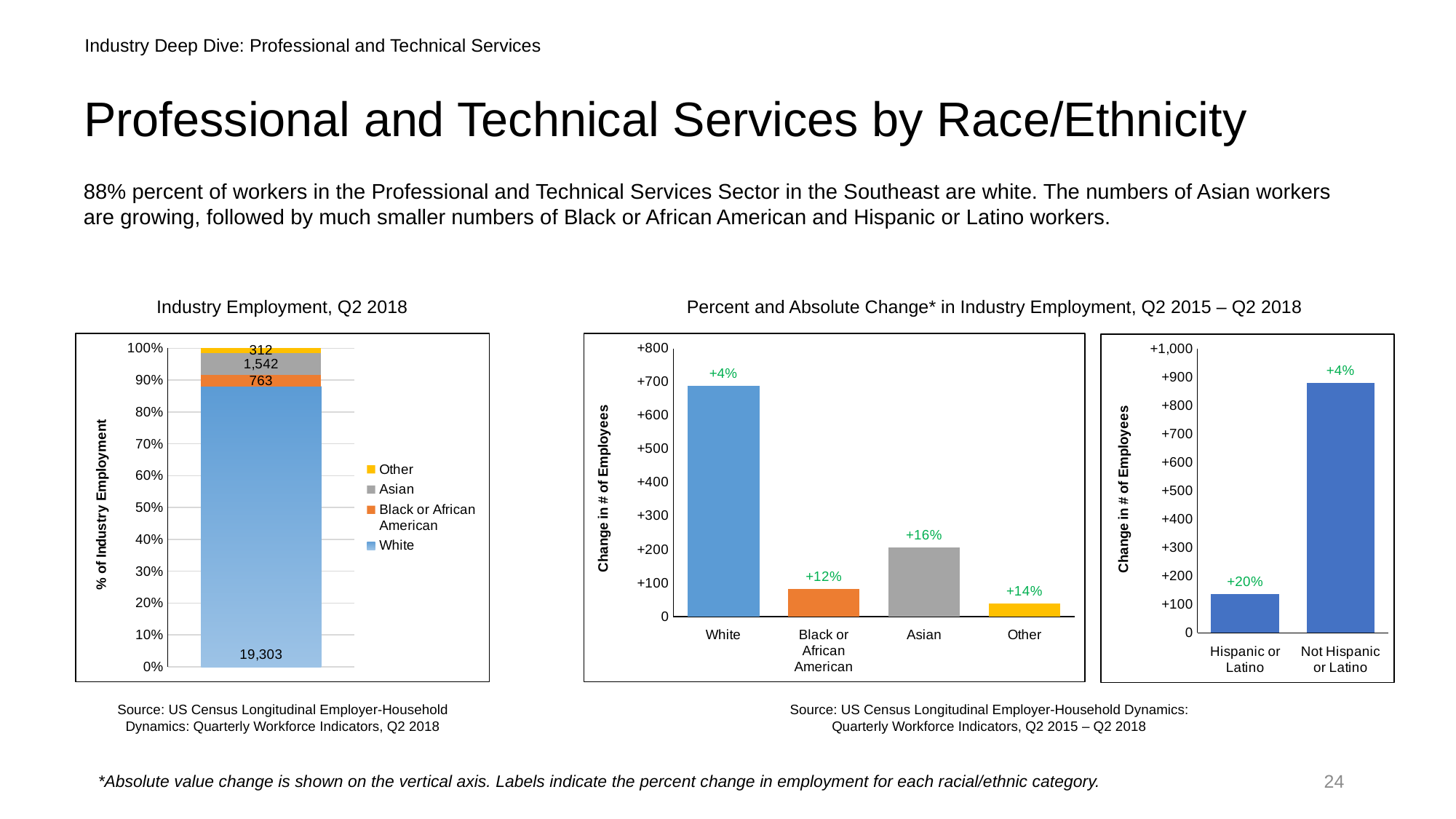
In the Industry Employment, Q2 2018 chart, how many White workers are shown? 19,303 In the Industry Employment, Q2 2018 chart, what is the value for Other? 312 In the rightmost chart (change in employment by Hispanic or Latino status), is the change in number of employees for Hispanic or Latino greater or less than +200? less In the Industry Employment, Q2 2018 chart, what is the value for Asian workers? 1,542 In the Industry Employment, Q2 2018 chart, what is the total of all four segments of the stacked bar? 21,920 In the rightmost chart (change in employment by Hispanic or Latino status), what percent change is labeled for Hispanic or Latino? +20% In the Industry Employment, Q2 2018 chart, how many more Asian workers are there than Black or African American workers? 779 In the middle chart (Percent and Absolute Change in Industry Employment by race), which category has the largest absolute change in number of employees? White In the middle chart (Percent and Absolute Change in Industry Employment by race), what percent change is labeled for Asian? +16% In the middle chart (Percent and Absolute Change in Industry Employment by race), is the change in number of employees for White greater or less than +600? greater How many series does the legend of the Industry Employment, Q2 2018 chart list? 4 In the middle chart (Percent and Absolute Change in Industry Employment by race), how many categories are shown on the x axis? 4